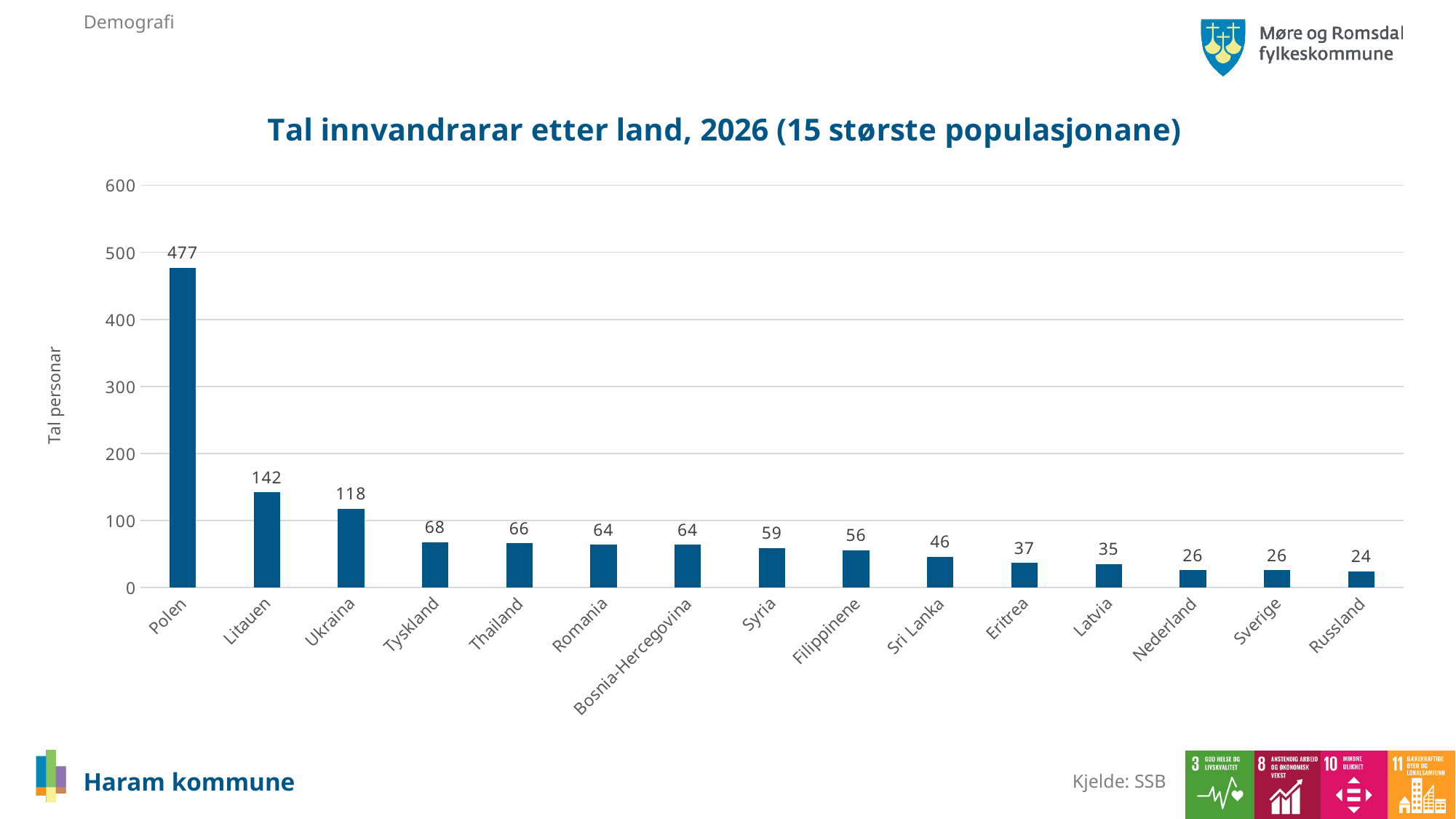
What is the value for Sri Lanka? 46 What is the value for Ukraina? 118 What kind of chart is shown on the slide? bar chart What is the difference between the values for Tyskland and Syria? 9 What is the value for Polen? 477 What is the difference between the values for Polen and Litauen? 335 Which is larger, the value for Eritrea or the value for Filippinene? Filippinene Is the value for Litauen greater or less than 100? greater Which country has the lowest value? Russland What is the title of the chart? Tal innvandrarar etter land, 2026 (15 største populasjonane) How many countries are shown in the chart? 15 Which country has the highest value? Polen